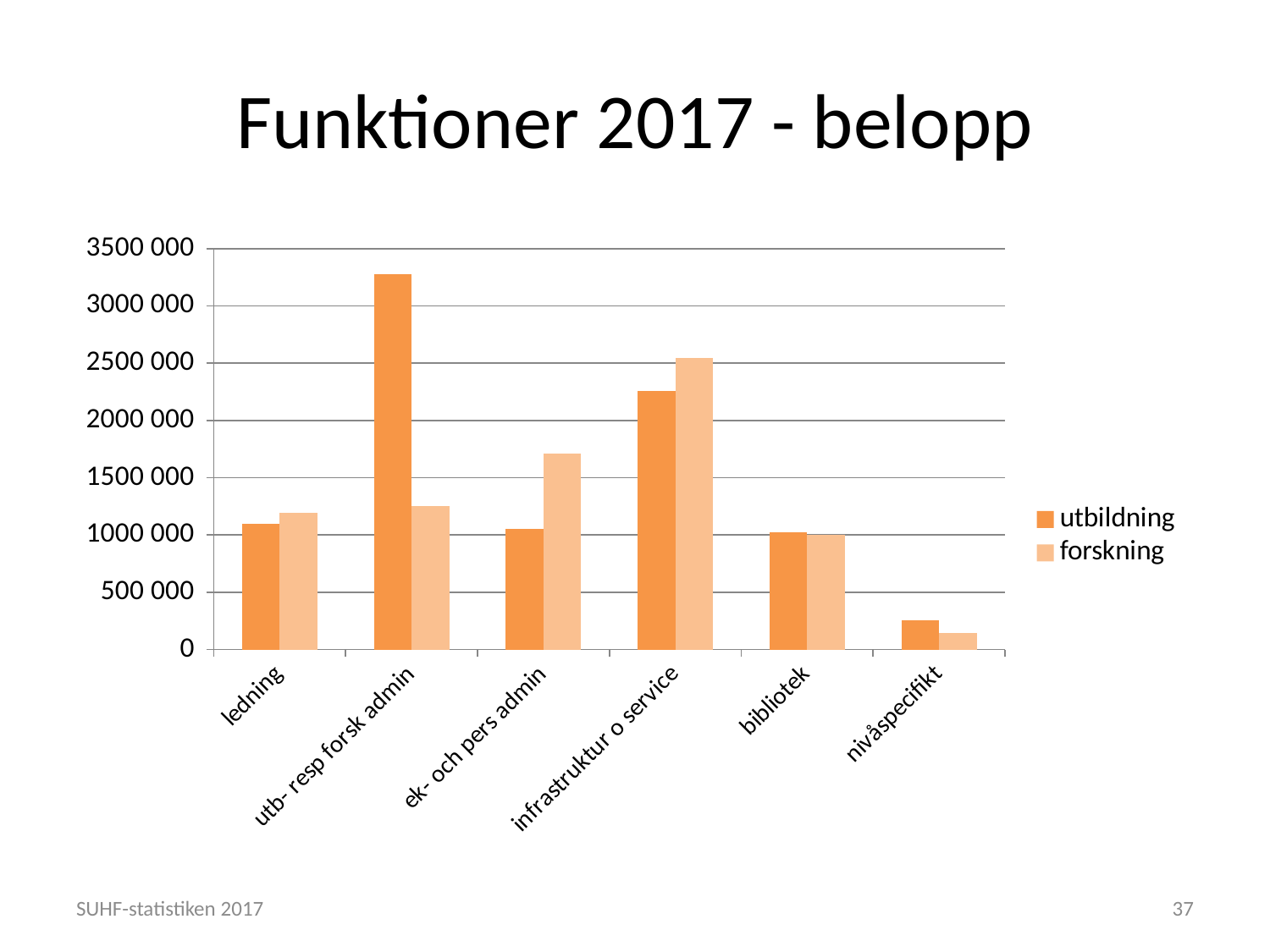
Is the utbildning value for utb- resp forsk admin greater or less than 3000 000? greater How many series does the legend list? 2 Which category has the lowest utbildning value? nivåspecifikt For infrastruktur o service, which series has the larger value, utbildning or forskning? forskning Is the forskning value for ek- och pers admin greater or less than 1500 000? greater What kind of chart is shown on the slide? bar chart Is the utbildning value for nivåspecifikt greater or less than 500 000? less Which category has the lowest forskning value? nivåspecifikt Which category has the highest utbildning value? utb- resp forsk admin How many categories are shown on the x axis? 6 What is the title of the chart? Funktioner 2017 - belopp Which category has the highest forskning value? infrastruktur o service